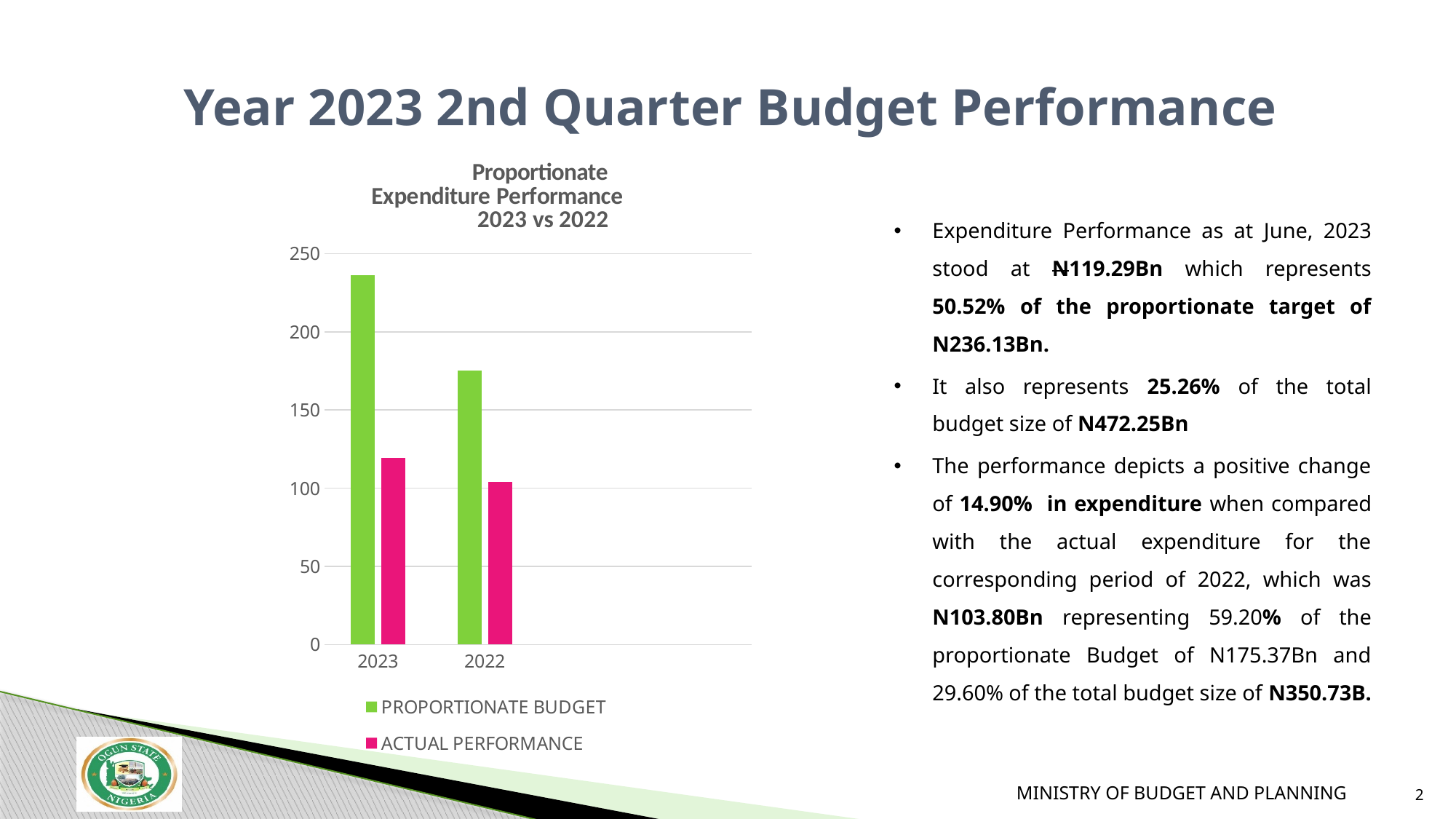
Which bar is the shortest in the chart? ACTUAL PERFORMANCE for 2022 What is the title of the chart? Proportionate Expenditure Performance 2023 vs 2022 Is the PROPORTIONATE BUDGET value for 2023 greater or less than 200? greater What kind of chart is shown on the slide? bar chart Which is larger, the PROPORTIONATE BUDGET for 2023 or the PROPORTIONATE BUDGET for 2022? PROPORTIONATE BUDGET for 2023 Is the PROPORTIONATE BUDGET value for 2022 greater or less than 200? less Which bar is the tallest in the chart? PROPORTIONATE BUDGET for 2023 Which is larger, the ACTUAL PERFORMANCE for 2023 or the ACTUAL PERFORMANCE for 2022? ACTUAL PERFORMANCE for 2023 Is the ACTUAL PERFORMANCE value for 2022 greater or less than 150? less Which series is shown in green in the chart? PROPORTIONATE BUDGET How many series does the chart legend list? 2 How many year categories are shown on the x axis of the chart? 2